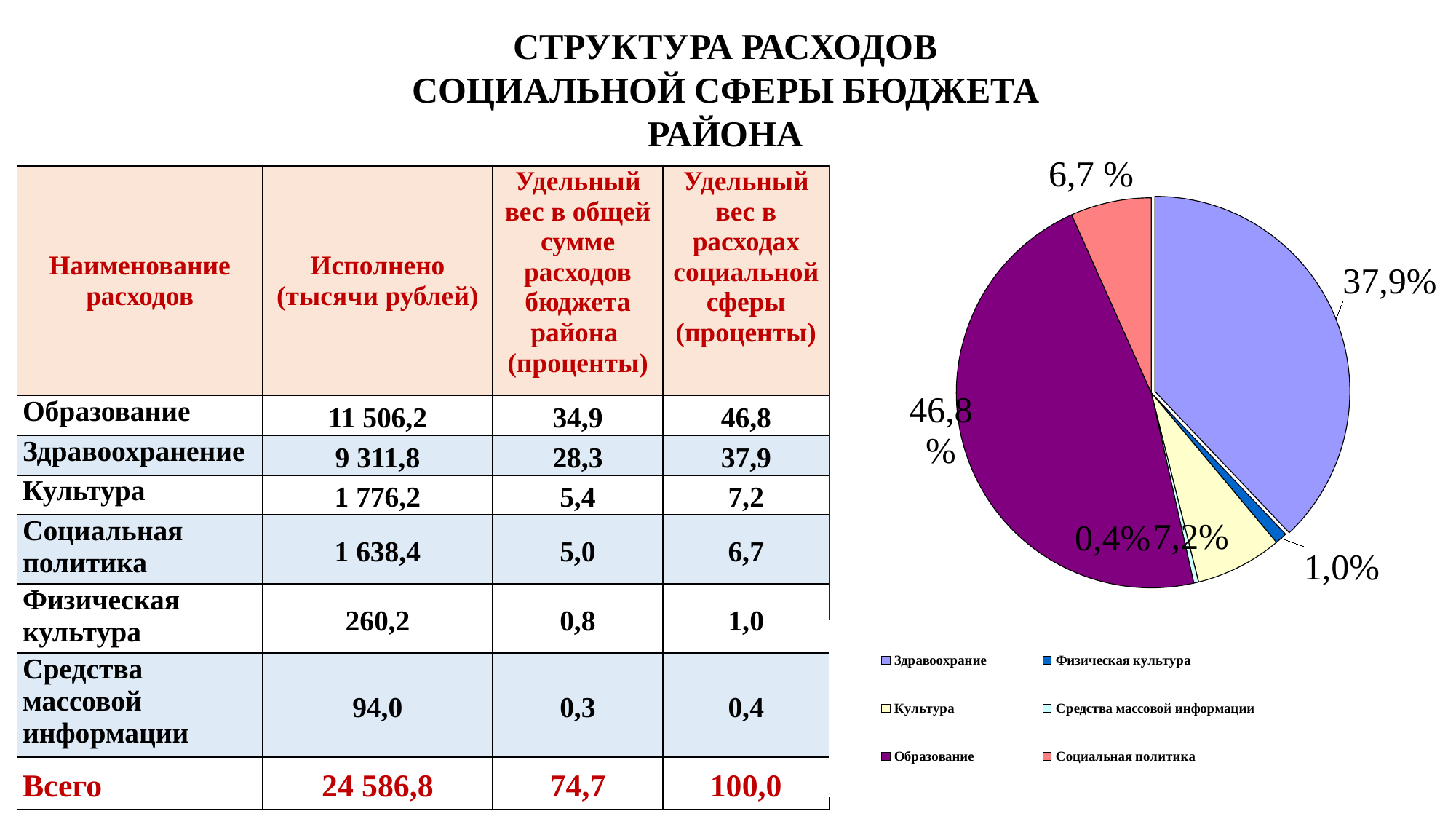
What share of the pie chart does Физическая культура have? 1,0% What share of the pie chart does Культура have? 7,2% What colour is the Образование slice in the pie chart? purple What share of the pie chart does Социальная политика have? 6,7 % What share of the pie chart does Средства массовой информации have? 0,4% Which category has the smallest slice in the pie chart? Средства массовой информации Which slice is larger in the pie chart, Культура or Социальная политика? Культура What share of the pie chart does Здравоохранение have? 37,9% Which category has the largest slice in the pie chart? Образование What share of the pie chart does Образование have? 46,8 % What kind of chart is shown on the slide? pie chart How many categories does the pie chart legend list? 6